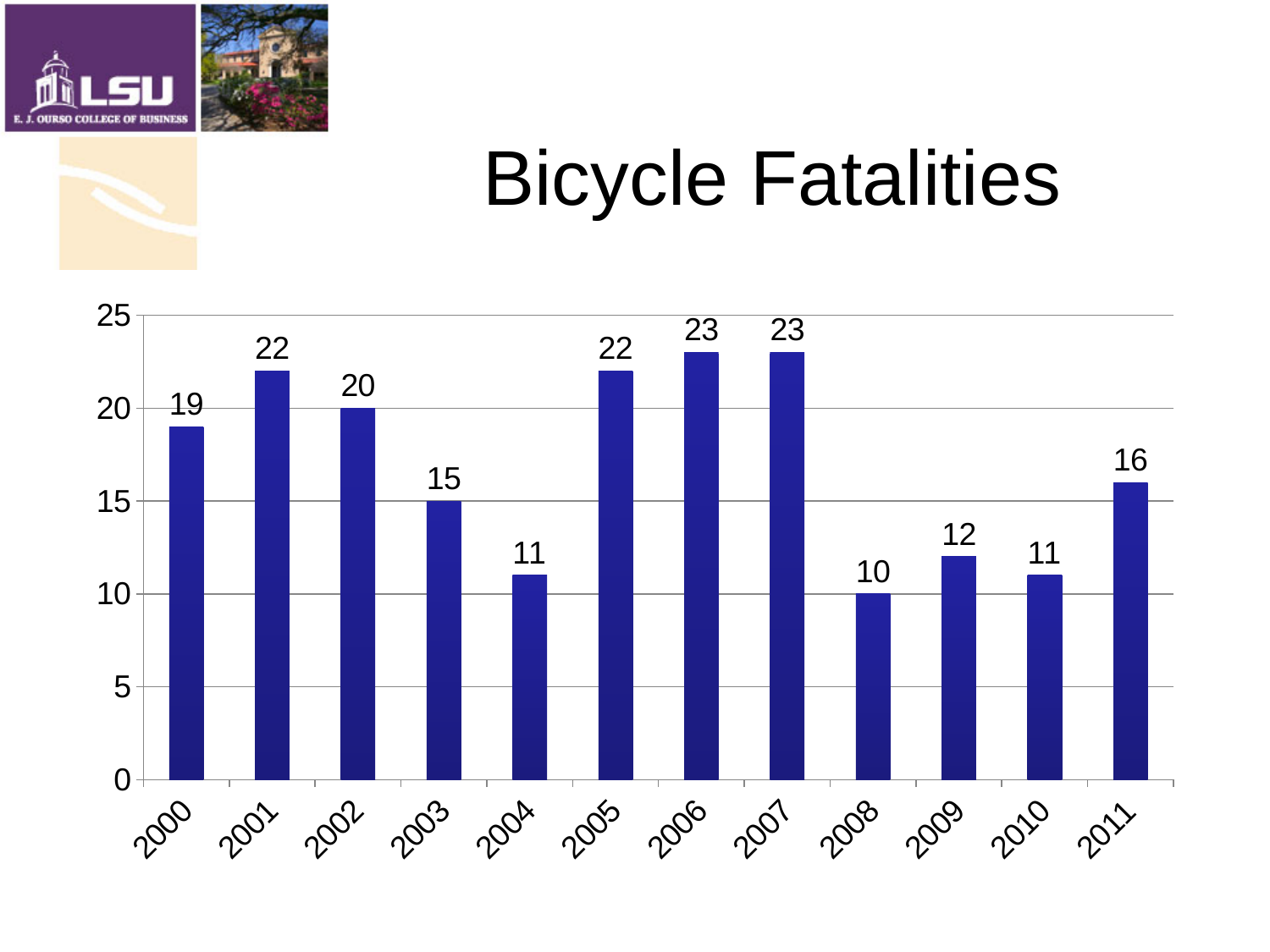
What is the value for 2004? 11 Do the values rise or fall from 2007 to 2008? fall Is the value for 2005 greater or less than 20? greater What kind of chart is shown on the slide? bar chart What is the difference between the values for 2001 and 2003? 7 How many years are shown on the x axis? 12 Which is larger, the value for 2002 or the value for 2009? 2002 What is the value for 2011? 16 What is the highest value shown on the chart? 23 What is the value for 2000? 19 Which year has the lowest value? 2008 What is the title of the chart? Bicycle Fatalities